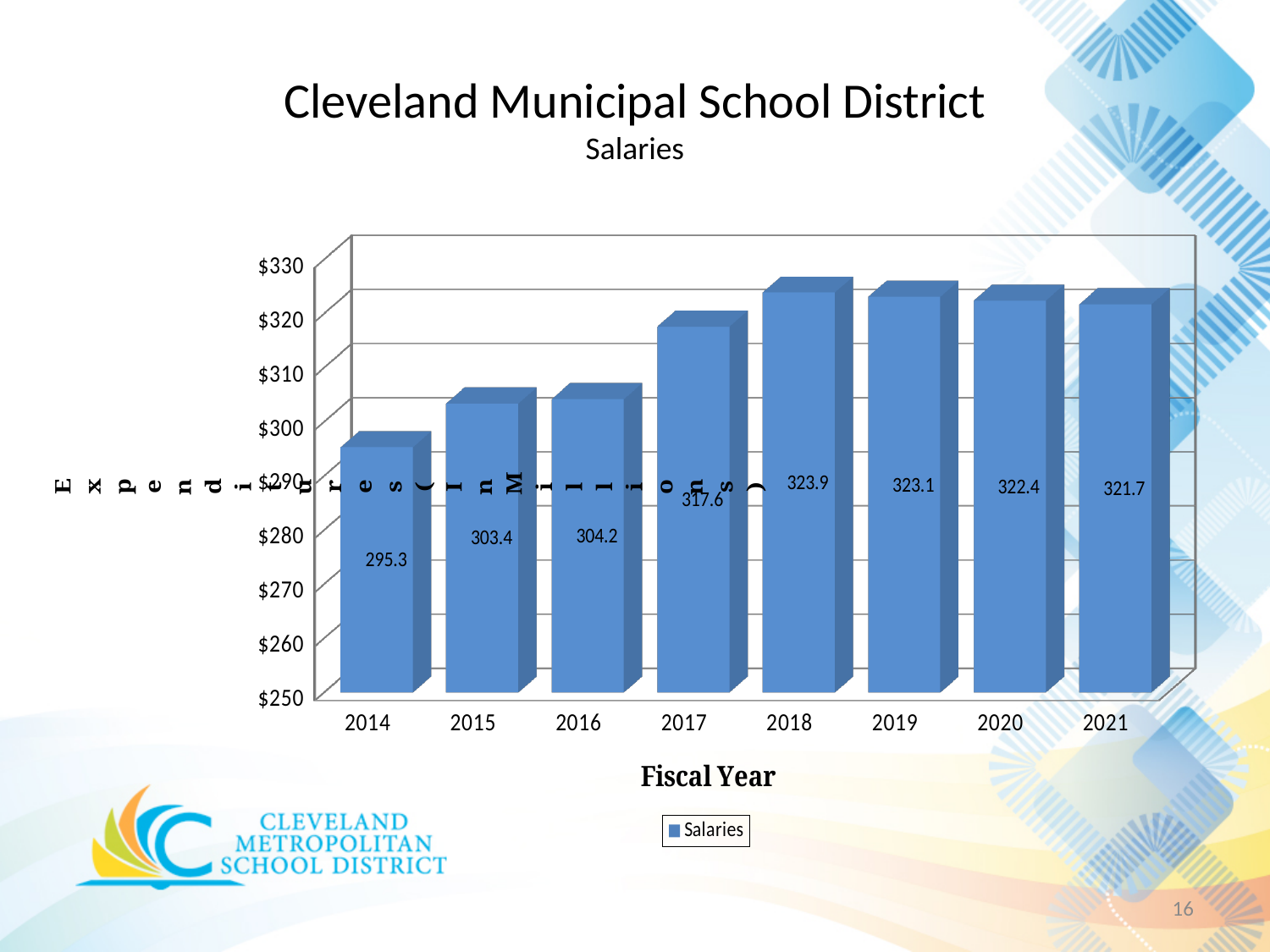
What is the value for 2021? 321.7 What is the label of the x axis? Fiscal Year What is the value for 2014? 295.3 Which fiscal year has the lowest value? 2014 What kind of chart is shown on the slide? bar chart What is the value for 2018? 323.9 Which fiscal year has the highest value? 2018 Is the value for 2016 greater or less than $300? greater Which is larger, the value for 2015 or the value for 2017? 2017 What is the difference between the values for 2018 and 2014? 28.6 What is the difference between the values for 2017 and 2016? 13.4 How many fiscal years are shown on the x axis? 8